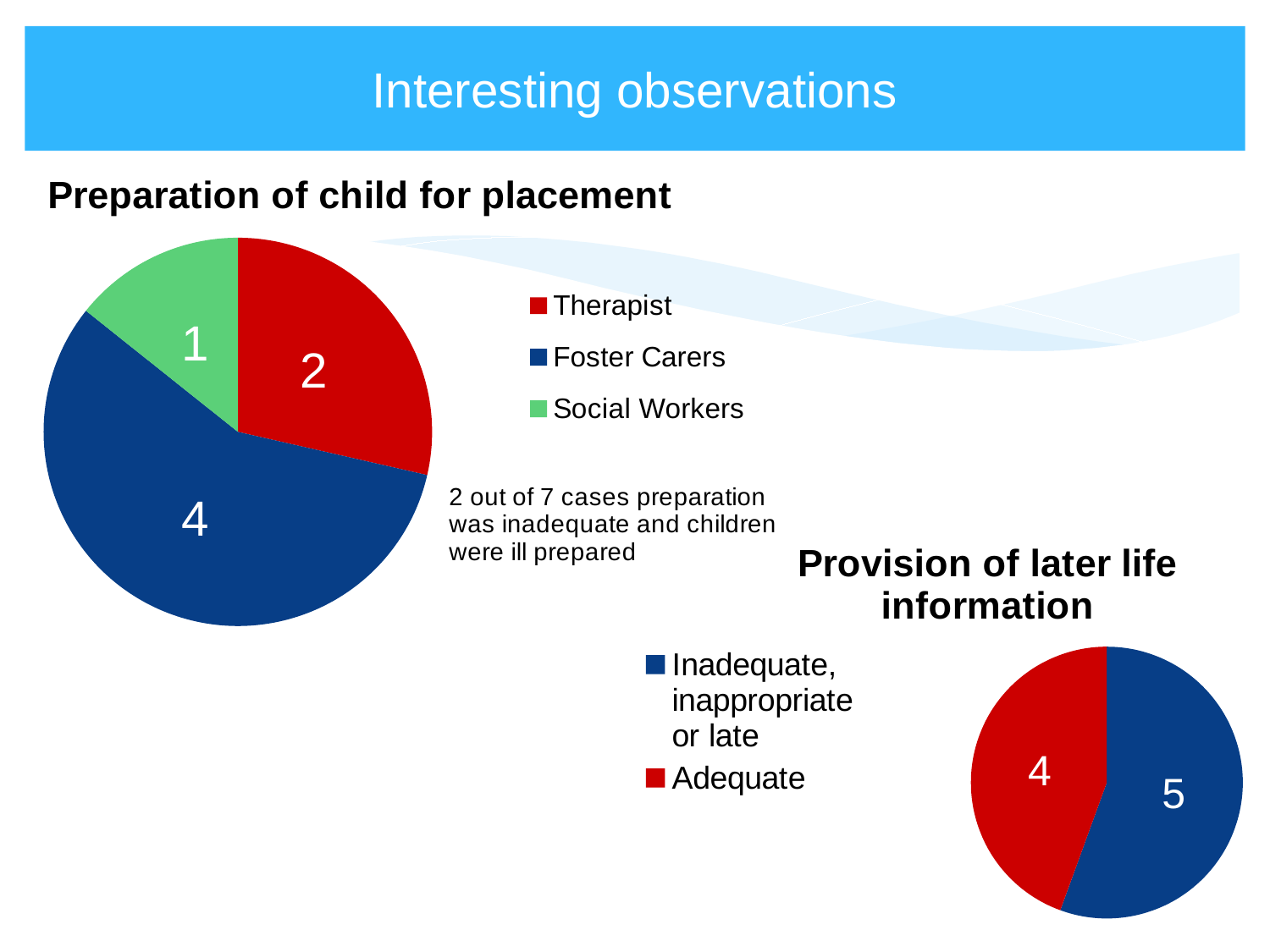
In the 'Preparation of child for placement' chart, which category has the smallest slice? Social Workers In the 'Provision of later life information' chart, what is the value for Adequate? 4 In the 'Provision of later life information' chart, what is the value for 'Inadequate, inappropriate or late'? 5 In the 'Preparation of child for placement' chart, what is the difference between the Foster Carers value and the Therapist value? 2 In the 'Preparation of child for placement' chart, what colour is the Social Workers slice? Green In the 'Preparation of child for placement' chart, what is the value for Social Workers? 1 In the 'Preparation of child for placement' chart, what is the value for Foster Carers? 4 In the 'Preparation of child for placement' chart, how many categories does the legend list? 3 In the 'Preparation of child for placement' chart, what is the value for Therapist? 2 What type of chart is the 'Provision of later life information' chart? Pie chart In the 'Provision of later life information' chart, which is larger: Adequate or 'Inadequate, inappropriate or late'? Inadequate, inappropriate or late In the 'Preparation of child for placement' chart, which category has the largest slice? Foster Carers